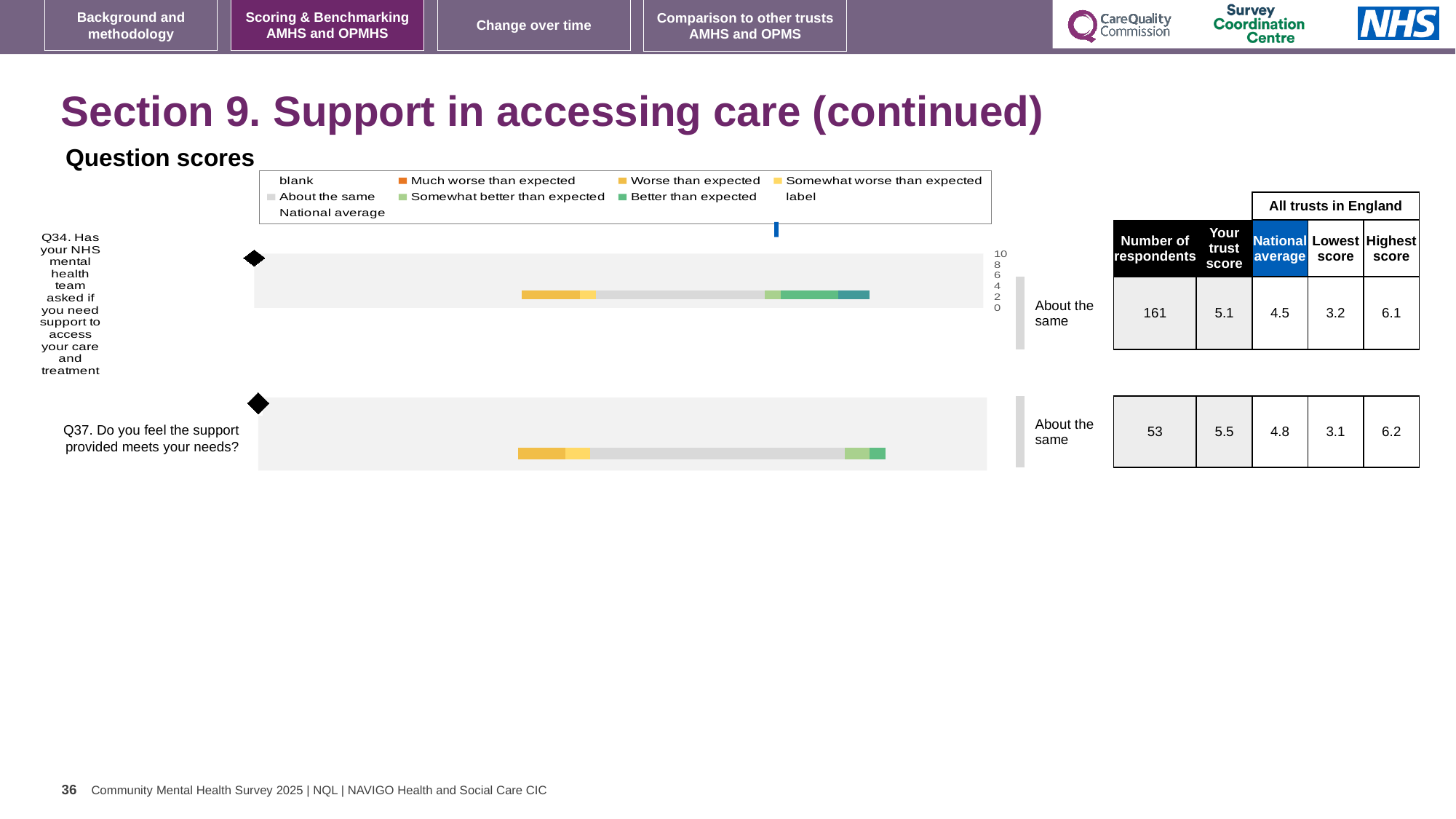
What kind of chart is used to show the question scores for Q34 and Q37? bar chart What is the number of respondents for Q34? 161 What is the difference between your trust score and the national average for Q37? 0.7 Which question has the higher trust score, Q34 or Q37? Q37 How many entries does the legend of the question scores chart list? 9 What is the highest score among all trusts in England for Q37? 6.2 What is the lowest score among all trusts in England for Q34? 3.2 Which benchmark category is shown next to the bar for Q34? About the same What is the national average score for Q34? 4.5 What is your trust score for Q37? 5.5 How many questions are plotted in the question scores chart? 2 Which benchmark category is shown next to the bar for Q37? About the same